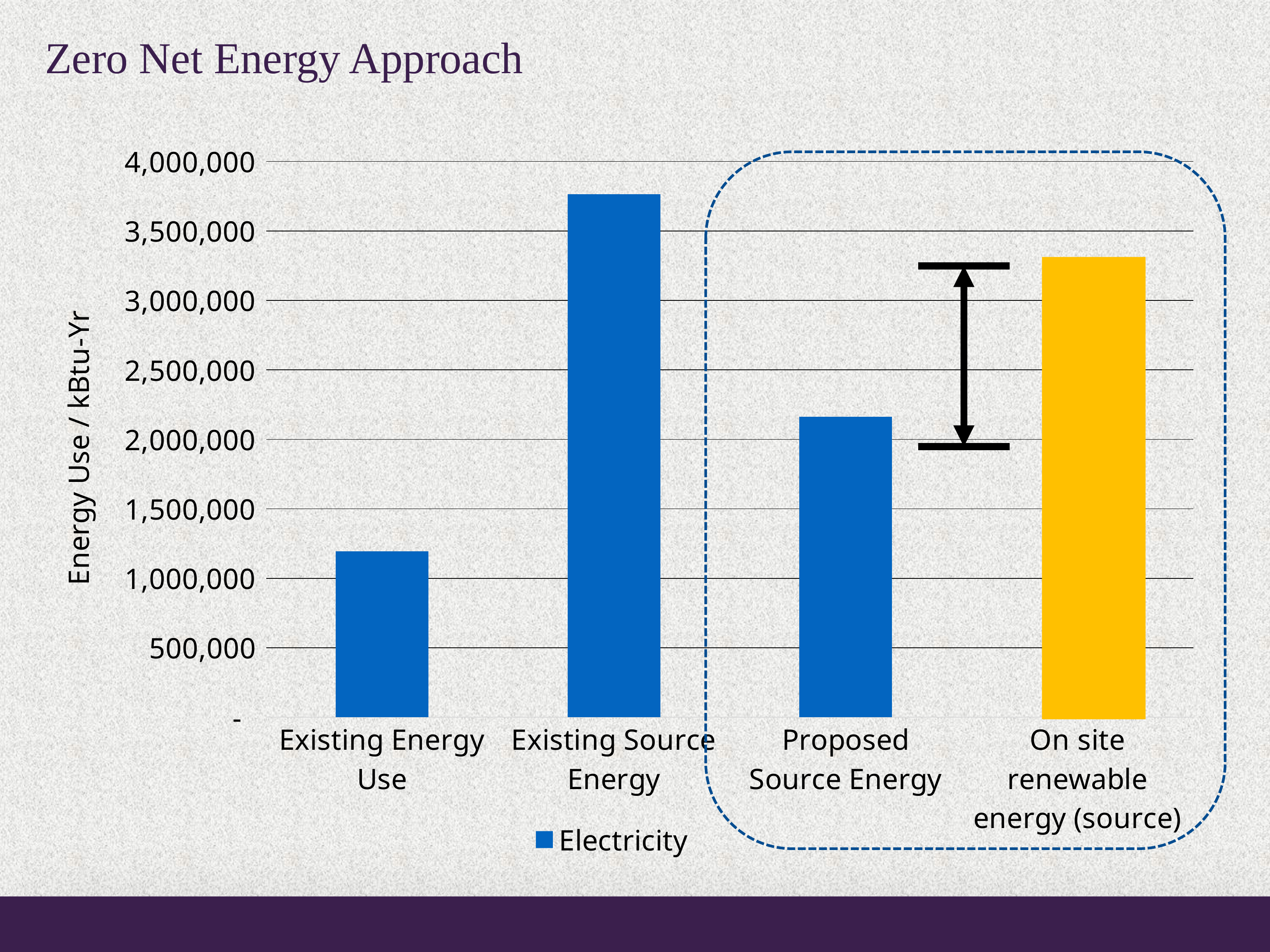
What is the name of the series listed in the chart's legend? Electricity Is the value for Existing Source Energy greater or less than 3,500,000? greater Is the value for Proposed Source Energy greater or less than 2,000,000? greater Which category has the highest bar in the chart? Existing Source Energy How many series does the chart's legend list? 1 What is the label on the vertical axis of the chart? Energy Use / kBtu-Yr How many categories are shown on the x axis of the chart? 4 Which category has the lowest bar in the chart? Existing Energy Use Which is larger, the value for Proposed Source Energy or the value for On site renewable energy (source)? On site renewable energy (source) Is the value for On site renewable energy (source) greater or less than 3,500,000? less What kind of chart is shown on the slide? bar chart